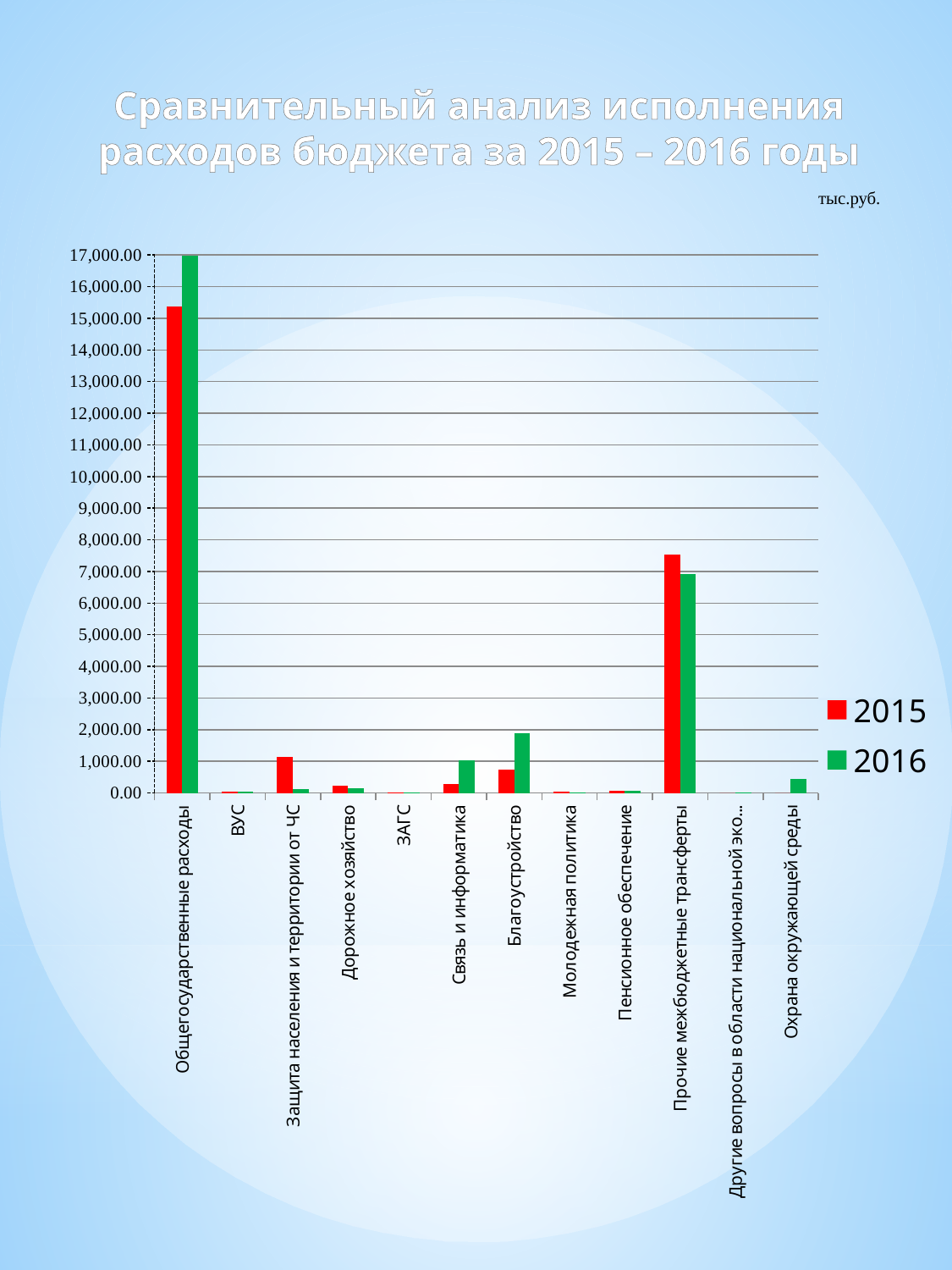
Which category has the highest value for 2016? Общегосударственные расходы What kind of chart is shown on the slide? bar chart Is the 2016 value for Благоустройство greater or less than 1,000.00? greater For Прочие межбюджетные трансферты, which year has the larger value, 2015 or 2016? 2015 How many expenditure categories are shown on the x axis? 12 For Общегосударственные расходы, which year has the larger value, 2015 or 2016? 2016 Which category has the highest value for 2015? Общегосударственные расходы What unit of measurement is indicated above the chart? тыс.руб. Is the 2015 value for Общегосударственные расходы greater or less than 15,000.00? greater Which years are listed in the legend? 2015 and 2016 How many series does the legend list? 2